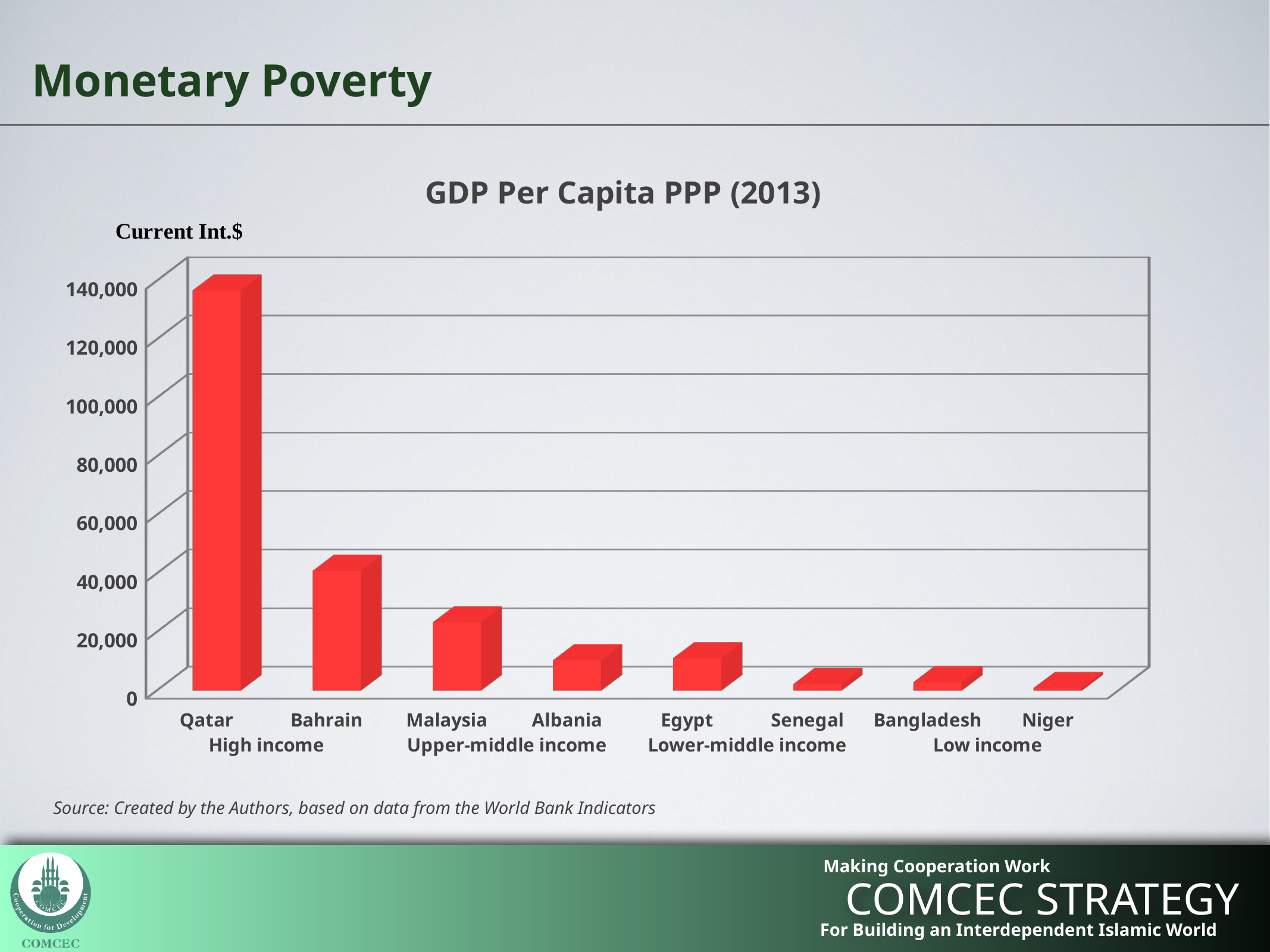
Which has a higher GDP per capita PPP, Qatar or Bahrain? Qatar Is the value for Albania greater or less than 20,000? less What unit is given for the vertical axis of the chart? Current Int.$ Is the value for Malaysia greater or less than 40,000? less What type of chart is shown on the slide? Bar chart Which has a higher GDP per capita PPP, Malaysia or Albania? Malaysia Do the values generally rise or fall moving from left to right along the x axis? Fall Which country has the highest GDP per capita PPP in the chart? Qatar Is the value for Qatar greater or less than 120,000? greater What is the title of the chart? GDP Per Capita PPP (2013) How many countries are shown on the x axis of the chart? 8